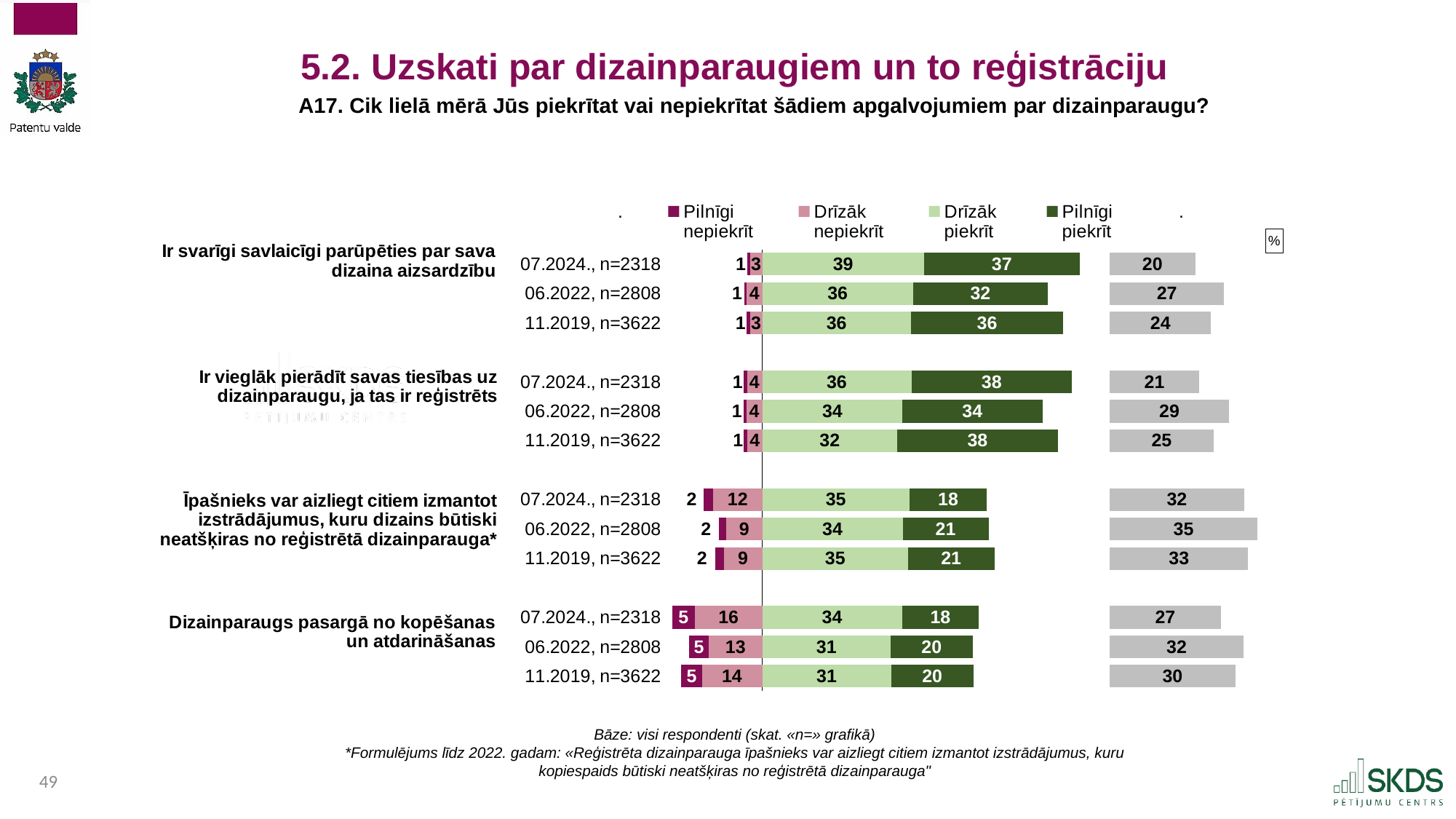
How many series does the legend list? 4 What is the sample size (n) for the 11.2019 survey wave? 3622 How many statements are shown in the chart? 4 What kind of chart is shown on the slide? Stacked bar chart What is the total of the four legend categories for "Dizainparaugs pasargā no kopēšanas un atdarināšanas" in 07.2024? 73 What is the difference between the "Pilnīgi piekrīt" values for "Ir svarīgi savlaicīgi parūpēties par sava dizaina aizsardzību" in 07.2024 and 06.2022? 5 What is the value shown in the grey bar for "Īpašnieks var aizliegt citiem izmantot izstrādājumus..." in 06.2022? 35 For "Dizainparaugs pasargā no kopēšanas un atdarināšanas", which survey wave has the highest "Drīzāk nepiekrīt" value? 07.2024 What is the value of "Drīzāk nepiekrīt" for "Dizainparaugs pasargā no kopēšanas un atdarināšanas" in 07.2024? 16 What is the value of "Pilnīgi piekrīt" for "Ir svarīgi savlaicīgi parūpēties par sava dizaina aizsardzību" in 07.2024? 37 In 07.2024, which statement has the larger "Drīzāk piekrīt" value: "Ir svarīgi savlaicīgi parūpēties par sava dizaina aizsardzību" or "Ir vieglāk pierādīt savas tiesības uz dizainparaugu, ja tas ir reģistrēts"? Ir svarīgi savlaicīgi parūpēties par sava dizaina aizsardzību What is the value of "Pilnīgi nepiekrīt" for "Īpašnieks var aizliegt citiem izmantot izstrādājumus..." in 11.2019? 2